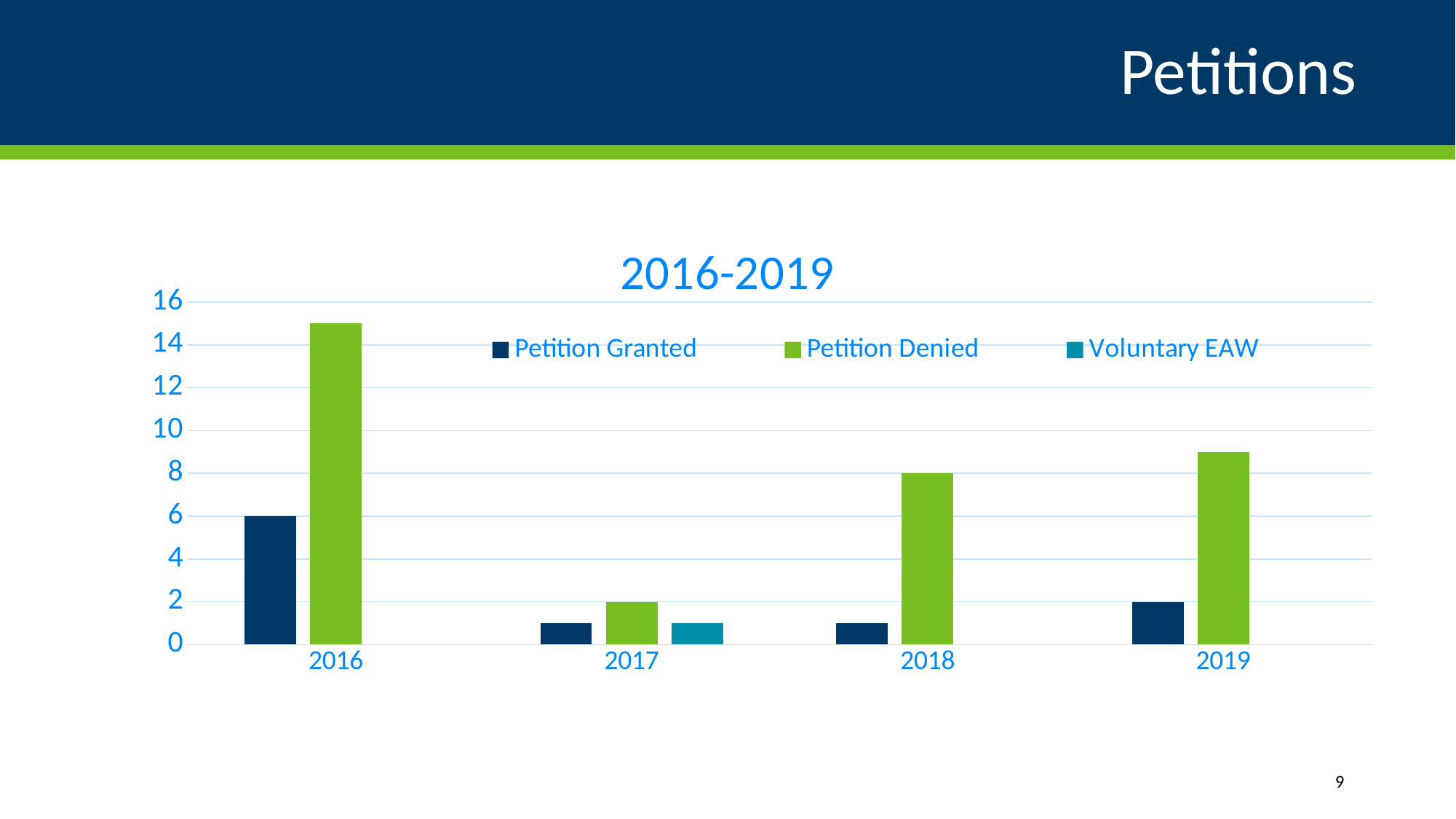
How many years are shown on the x axis of the chart? 4 How many series does the chart legend list? 3 What is the value for Petition Granted in 2019? 2 What is the difference between Petition Denied in 2018 and Petition Denied in 2017? 6 What kind of chart is shown on the slide? bar chart What is the value for Petition Denied in 2018? 8 Which is larger in 2018, Petition Granted or Petition Denied? Petition Denied What is the value for Petition Denied in 2017? 2 What is the value for Petition Granted in 2016? 6 Is the value for Petition Denied in 2016 greater or less than 14? greater In which year is Petition Denied highest? 2016 Is the value for Petition Denied in 2019 greater or less than 10? less